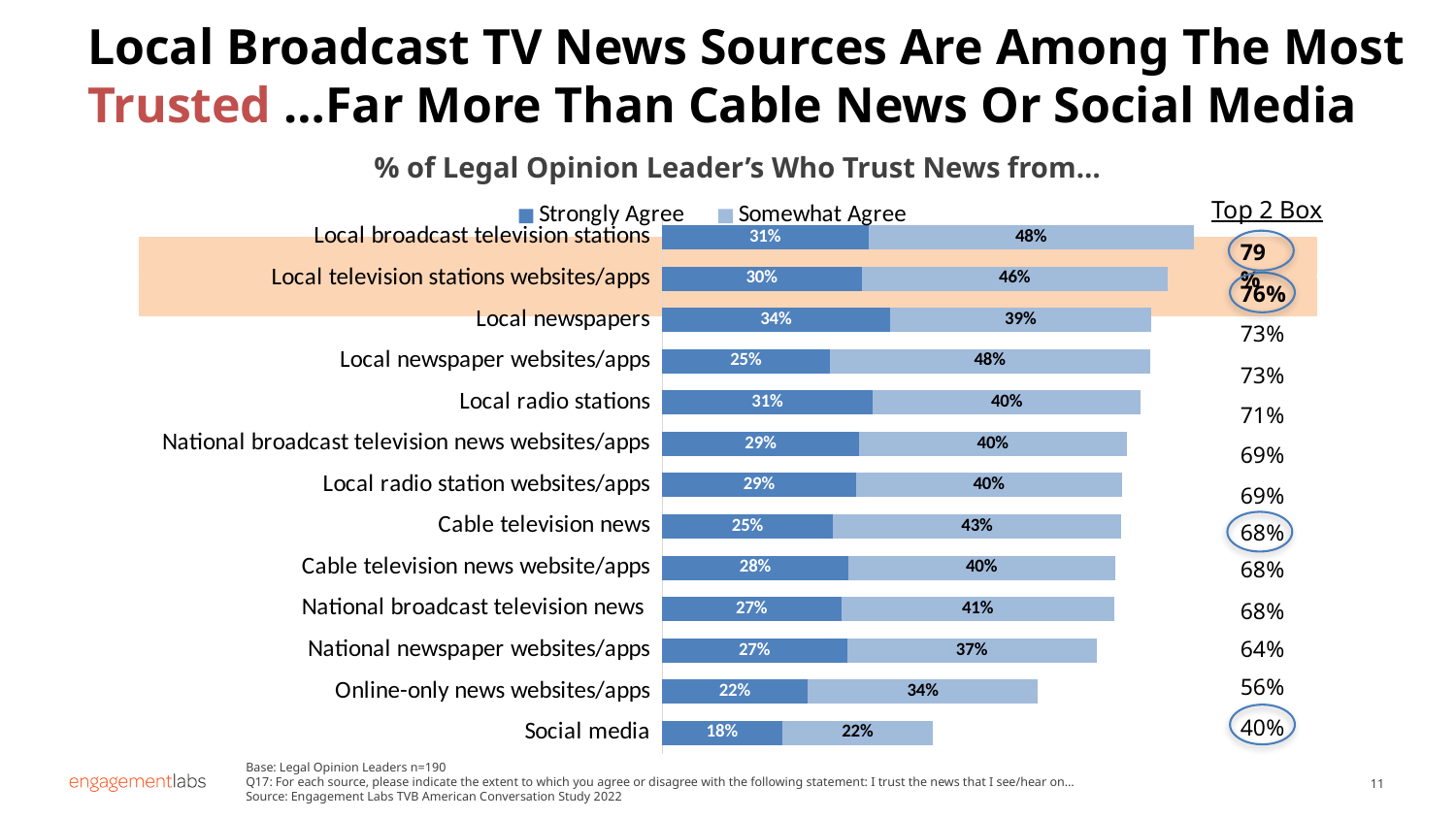
Which news source has the lowest Somewhat Agree value? Social media What kind of chart is shown on the slide? bar chart How many news sources (categories) are plotted in the chart? 13 What is the difference between the Somewhat Agree values for Local broadcast television stations and Social media? 26% What is the total of the stacked bar for Social media (Strongly Agree plus Somewhat Agree)? 40% What is the Strongly Agree value for Local broadcast television stations? 31% What is the subtitle of the chart? % of Legal Opinion Leader's Who Trust News from... Which has a larger Strongly Agree value: Local newspapers or Online-only news websites/apps? Local newspapers Which news source has the highest Strongly Agree value? Local newspapers How many series does the legend list? 2 What is the Strongly Agree value for Social media? 18% What is the Somewhat Agree value for Cable television news? 43%